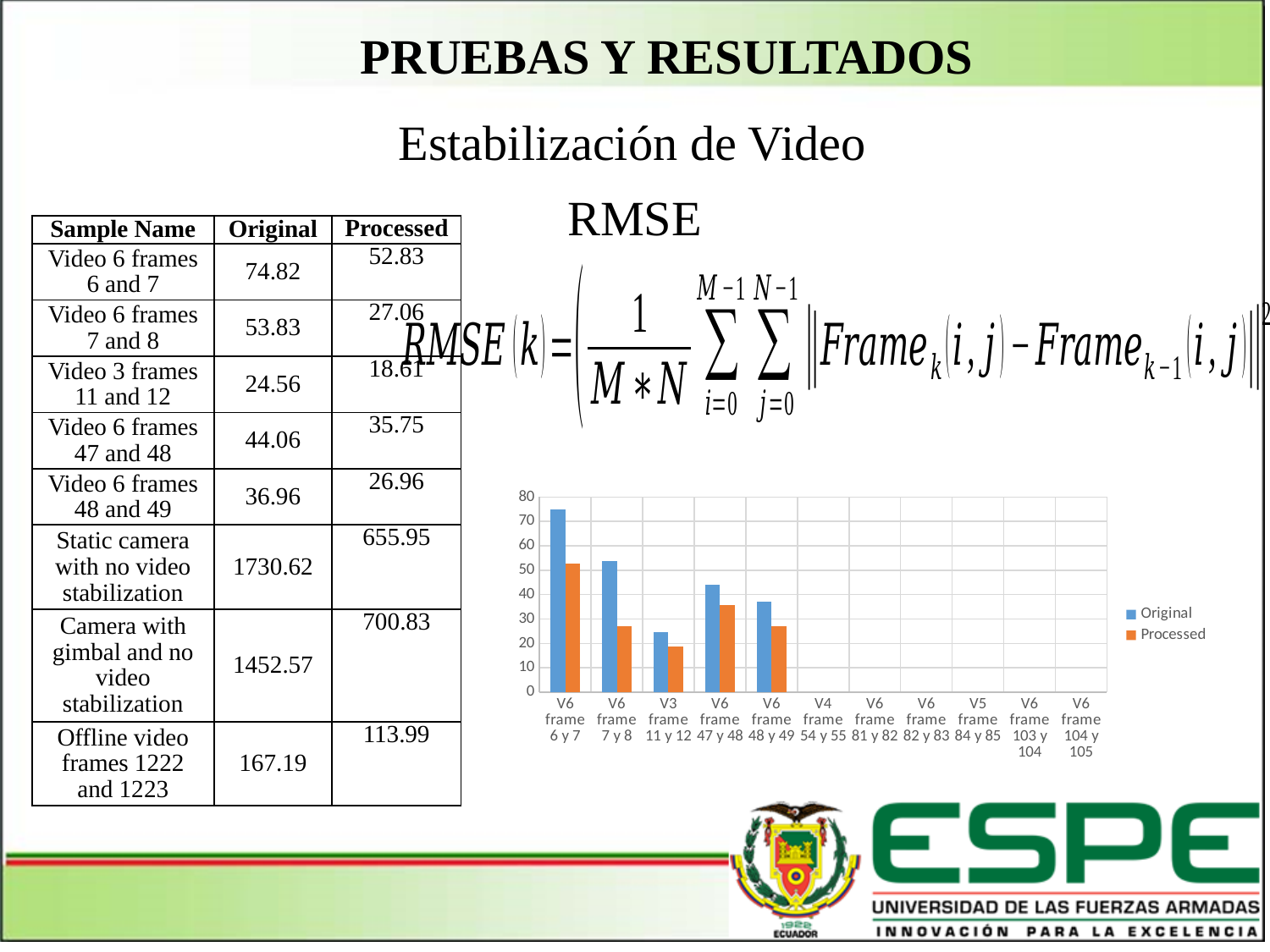
What colour represents the Processed series in the chart legend? orange Is the Original value for V3 frame 11 y 12 greater or less than 30? less For V6 frame 6 y 7, which is larger, the Original or the Processed bar? Original Which category has the highest Original bar in the chart? V6 frame 6 y 7 Is the Original value for V6 frame 6 y 7 greater or less than 70? greater How many categories are labelled along the x axis of the chart? 11 Which is larger, the Original bar for V6 frame 7 y 8 or the Original bar for V6 frame 47 y 48? V6 frame 7 y 8 How many series does the chart legend list? 2 Is the Processed value for V6 frame 7 y 8 greater or less than 30? less Among the categories with visible bars, which has the lowest Original bar? V3 frame 11 y 12 What kind of chart is shown on the slide? bar chart